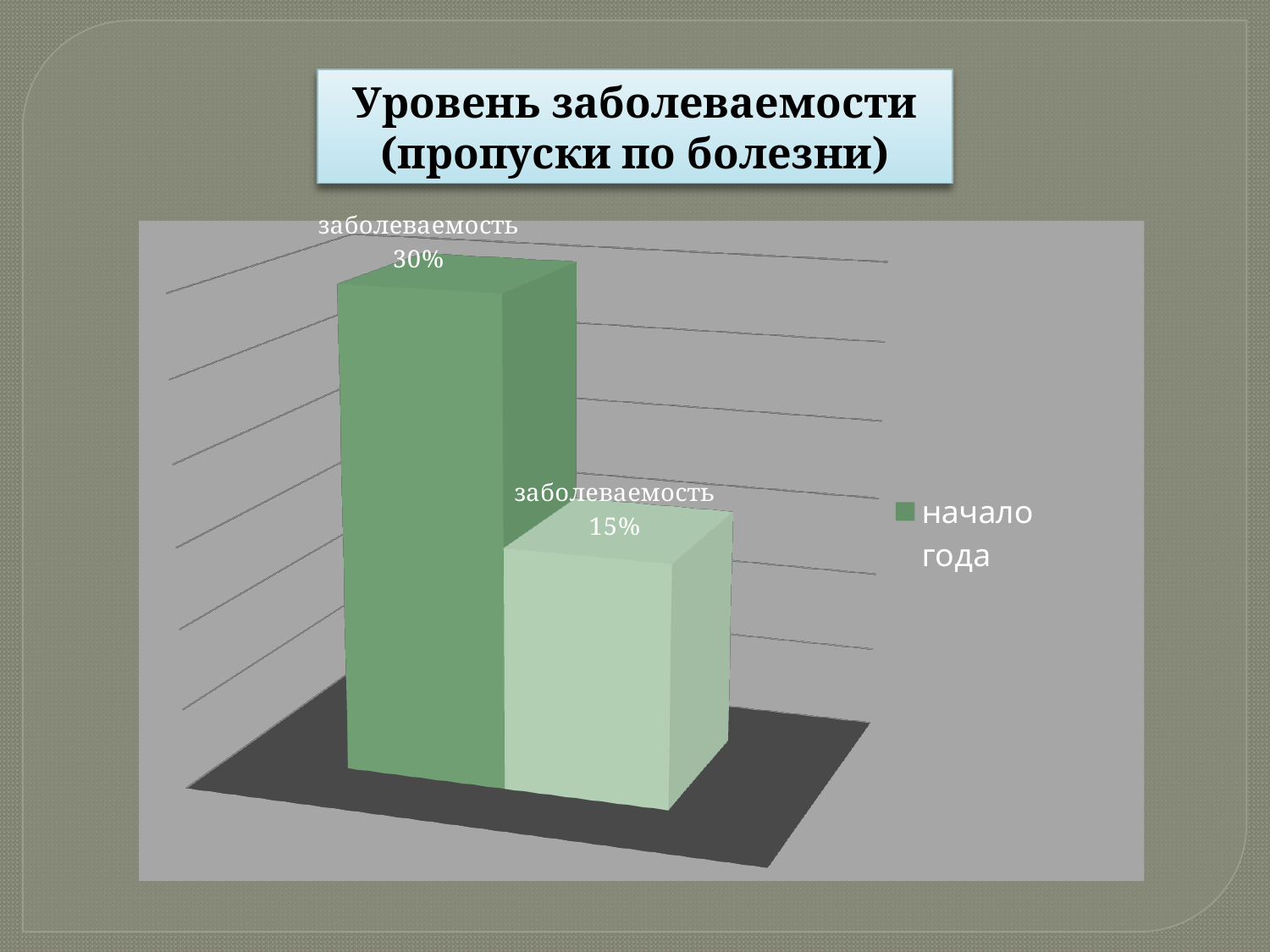
What kind of chart is shown on the slide? bar chart Which bar is taller, the dark green one or the light green one? the dark green one What text appears in the chart legend? начало года How many bars are plotted on the chart? 2 What is the title of the slide? Уровень заболеваемости (пропуски по болезни) What value is shown on the shorter, light green bar? 15% What value is shown on the taller, dark green bar? 30% What is the lowest value shown on the chart? 15% How many entries does the legend list? 1 What is the difference between the two bar values, 30% and 15%? 15% What is the highest value shown on the chart? 30%